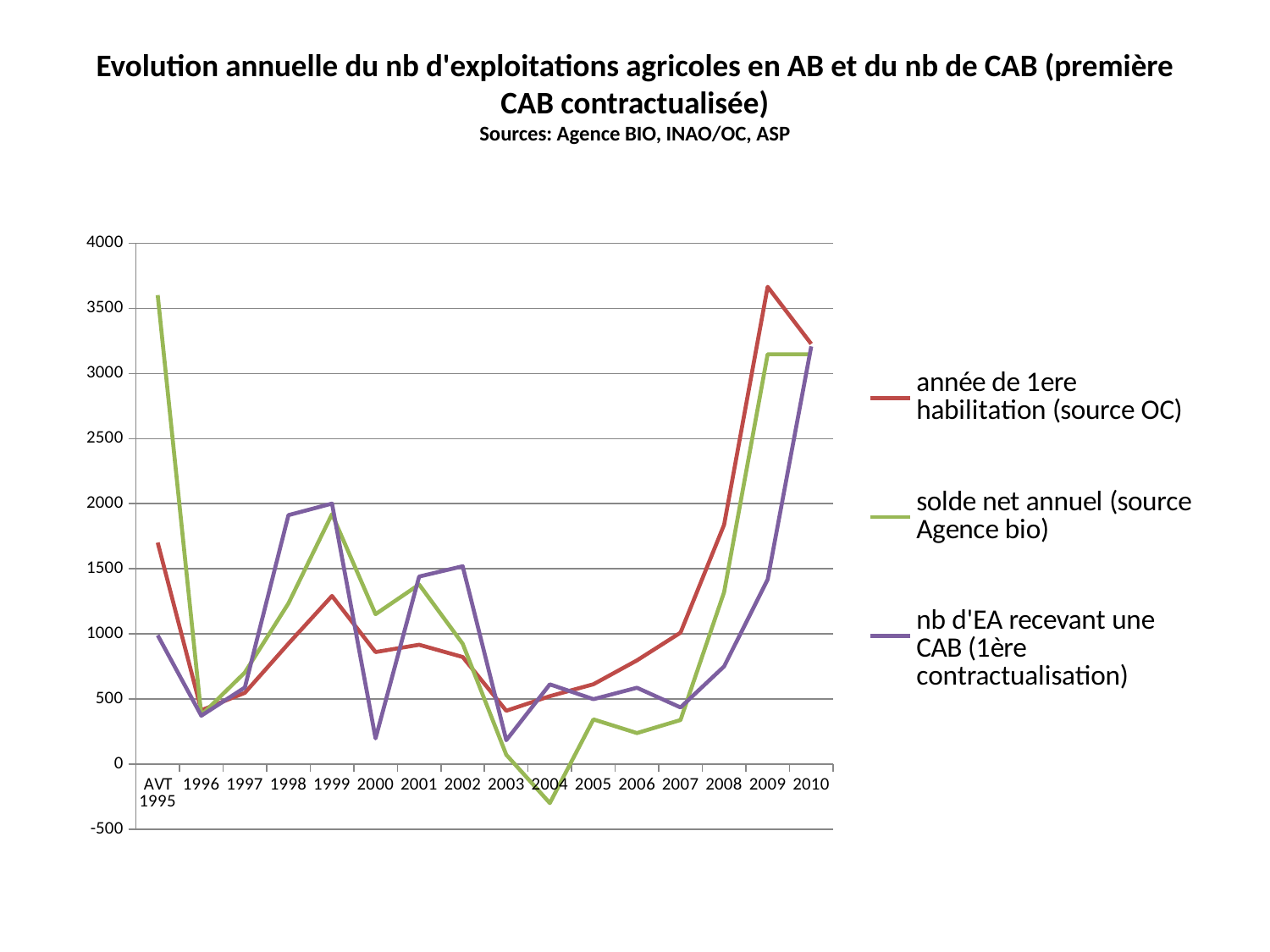
How many series does the legend list? 3 Is the value for 'solde net annuel (source Agence bio)' in 2004 greater or less than 0? less In which year does the 'solde net annuel (source Agence bio)' series reach its lowest value? 2004 Is the value for 'année de 1ere habilitation (source OC)' in 2009 greater or less than 3500? greater Is the value for 'nb d'EA recevant une CAB (1ère contractualisation)' in 1998 greater or less than 1500? greater What kind of chart is shown on the slide? line chart How many years (categories) are shown on the x axis? 16 In 2009, which series is higher: 'année de 1ere habilitation (source OC)' or 'solde net annuel (source Agence bio)'? année de 1ere habilitation (source OC) Does the 'année de 1ere habilitation (source OC)' series rise or fall between 2007 and 2009? rise In which year does the 'année de 1ere habilitation (source OC)' series reach its highest value? 2009 What sources are cited under the chart title? Agence BIO, INAO/OC, ASP